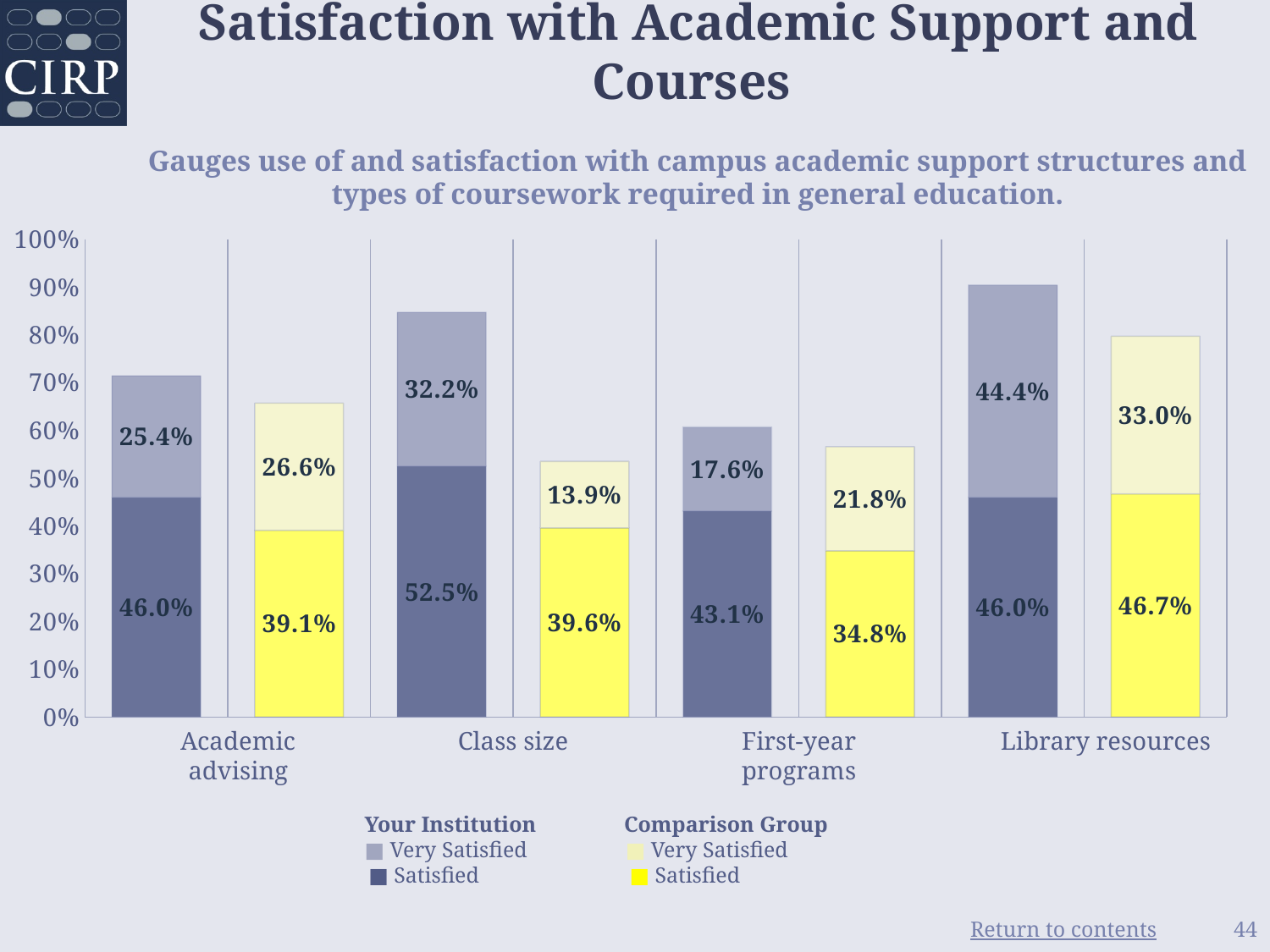
Which category has the lowest Very Satisfied value for the Comparison Group? Class size What is the Satisfied value for the Comparison Group for First-year programs? 34.8% Which is larger for First-year programs: the Very Satisfied value for Your Institution or for the Comparison Group? Comparison Group How many categories are shown on the x axis? 4 What is the Very Satisfied value for Your Institution for Library resources? 44.4% What kind of chart is shown on the slide? Stacked bar chart What percentage of Your Institution respondents were Satisfied with Academic advising? 46.0% How many series does the legend list? 4 Which category has the highest Very Satisfied value for Your Institution? Library resources What percentage of the Comparison Group was Very Satisfied with Class size? 13.9% What is the total of the Your Institution stacked bar (Satisfied plus Very Satisfied) for Library resources? 90.4% What is the difference between the Your Institution Satisfied value and the Comparison Group Satisfied value for Class size? 12.9%